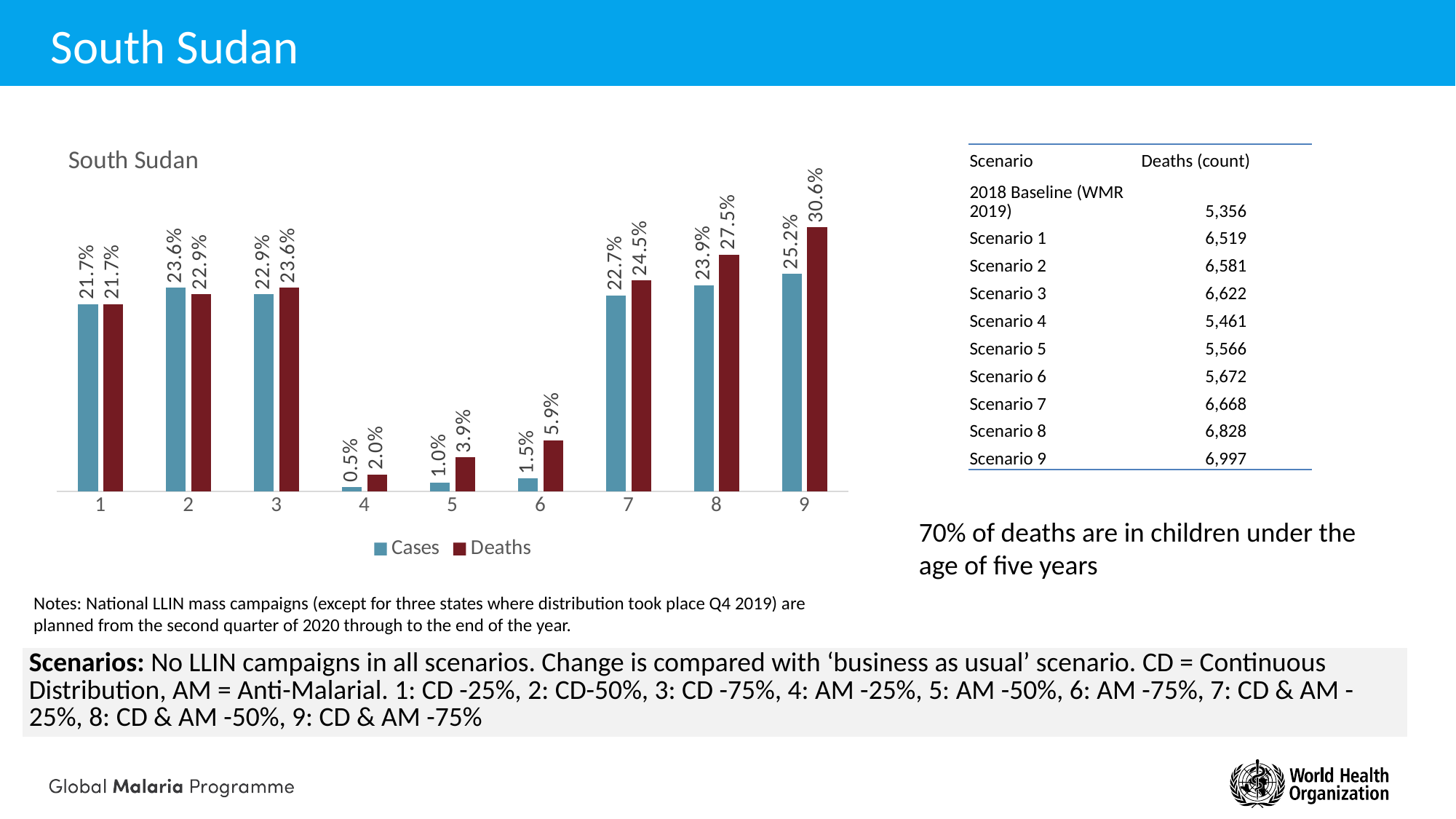
Which is larger for category 6, the Cases value or the Deaths value? Deaths How many categories are shown on the x axis? 9 What is the Cases value for category 8? 23.9% Which category has the lowest Cases value? 4 What is the Deaths value for category 9? 30.6% How many series does the legend list? 2 What are the two series named in the legend? Cases and Deaths What is the Deaths value for category 5? 3.9% What kind of chart is shown? Bar chart What is the Cases value for category 4? 0.5% Which category has the highest Deaths value? 9 What is the difference between the Deaths and Cases values for category 9? 5.4%